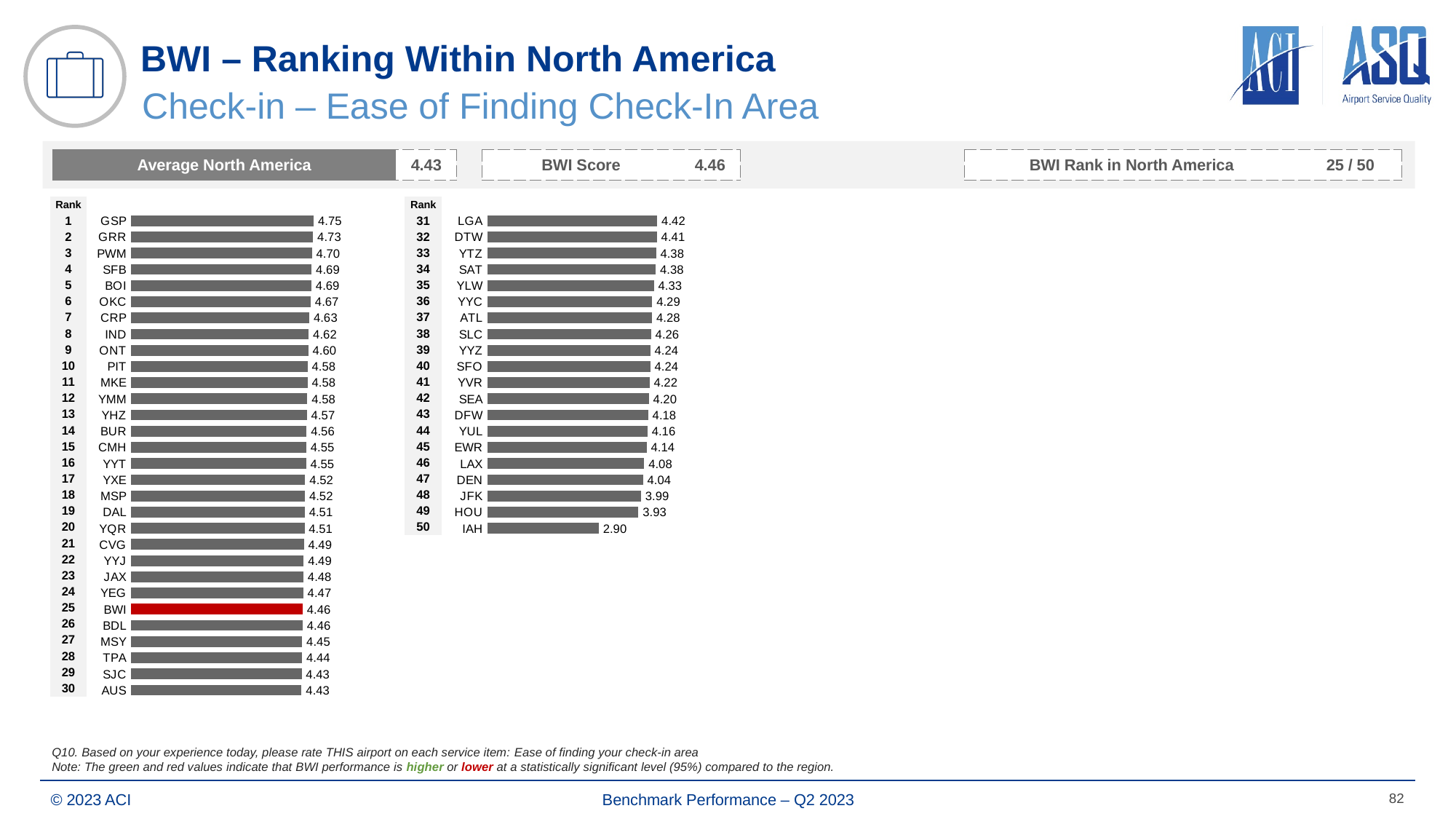
On the left chart (ranks 1-30), which airport's bar is highlighted in red? BWI On the right chart (ranks 31-50), what is the value for IAH? 2.90 On the right chart (ranks 31-50), what is the value for LAX? 4.08 On the left chart (ranks 1-30), which airport has the highest value? GSP On the left chart (ranks 1-30), what is the difference between the values for GSP and BWI? 0.29 On the left chart (ranks 1-30), what is the value for BWI? 4.46 On the left chart (ranks 1-30), what is the value for GSP? 4.75 On the right chart (ranks 31-50), which has a larger value, DEN or JFK? DEN How many airports are plotted on the right chart (ranks 31-50)? 20 What type of chart is used on the slide to show the airport rankings? Bar chart On the right chart (ranks 31-50), what is the difference between the values for LGA and IAH? 1.52 On the right chart (ranks 31-50), which airport has the lowest value? IAH